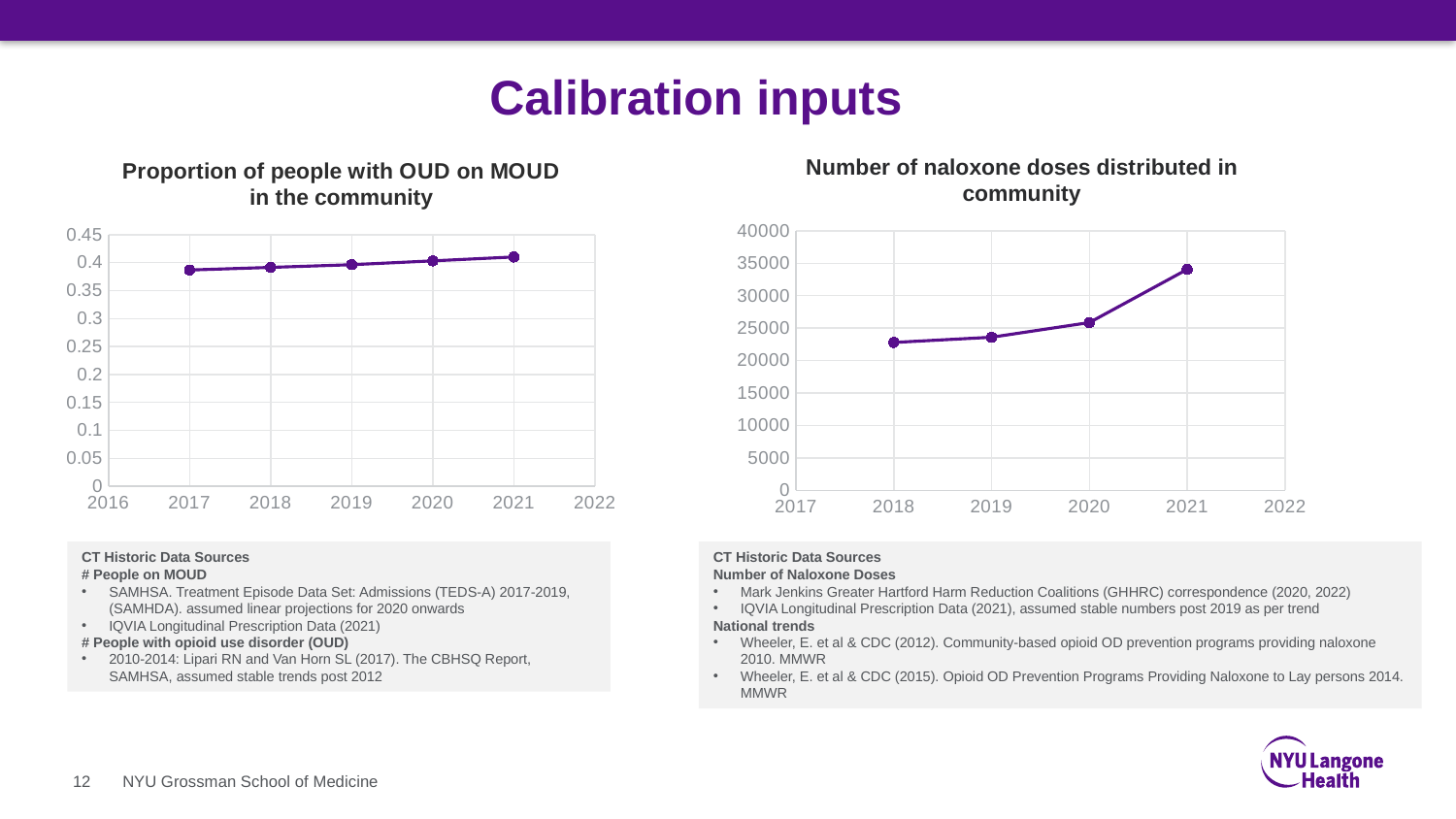
What type of chart is the 'Number of naloxone doses distributed in community' chart? line chart In the 'Number of naloxone doses distributed in community' chart, how many data points are plotted? 4 In the 'Proportion of people with OUD on MOUD in the community' chart, how many data points are plotted? 5 In the 'Number of naloxone doses distributed in community' chart, do the values rise or fall from 2018 to 2021? rise In the 'Number of naloxone doses distributed in community' chart, which is larger, the value for 2020 or the value for 2021? 2021 In the 'Number of naloxone doses distributed in community' chart, is the value for 2018 greater or less than 25000? less In the 'Number of naloxone doses distributed in community' chart, which year has the highest value? 2021 In the 'Proportion of people with OUD on MOUD in the community' chart, do the values rise or fall from 2017 to 2021? rise What type of chart is the 'Proportion of people with OUD on MOUD in the community' chart? line chart In the 'Number of naloxone doses distributed in community' chart, is the value for 2021 greater or less than 30000? greater In the 'Proportion of people with OUD on MOUD in the community' chart, is the value for 2021 greater or less than 0.35? greater In the 'Number of naloxone doses distributed in community' chart, which year has the lowest value? 2018